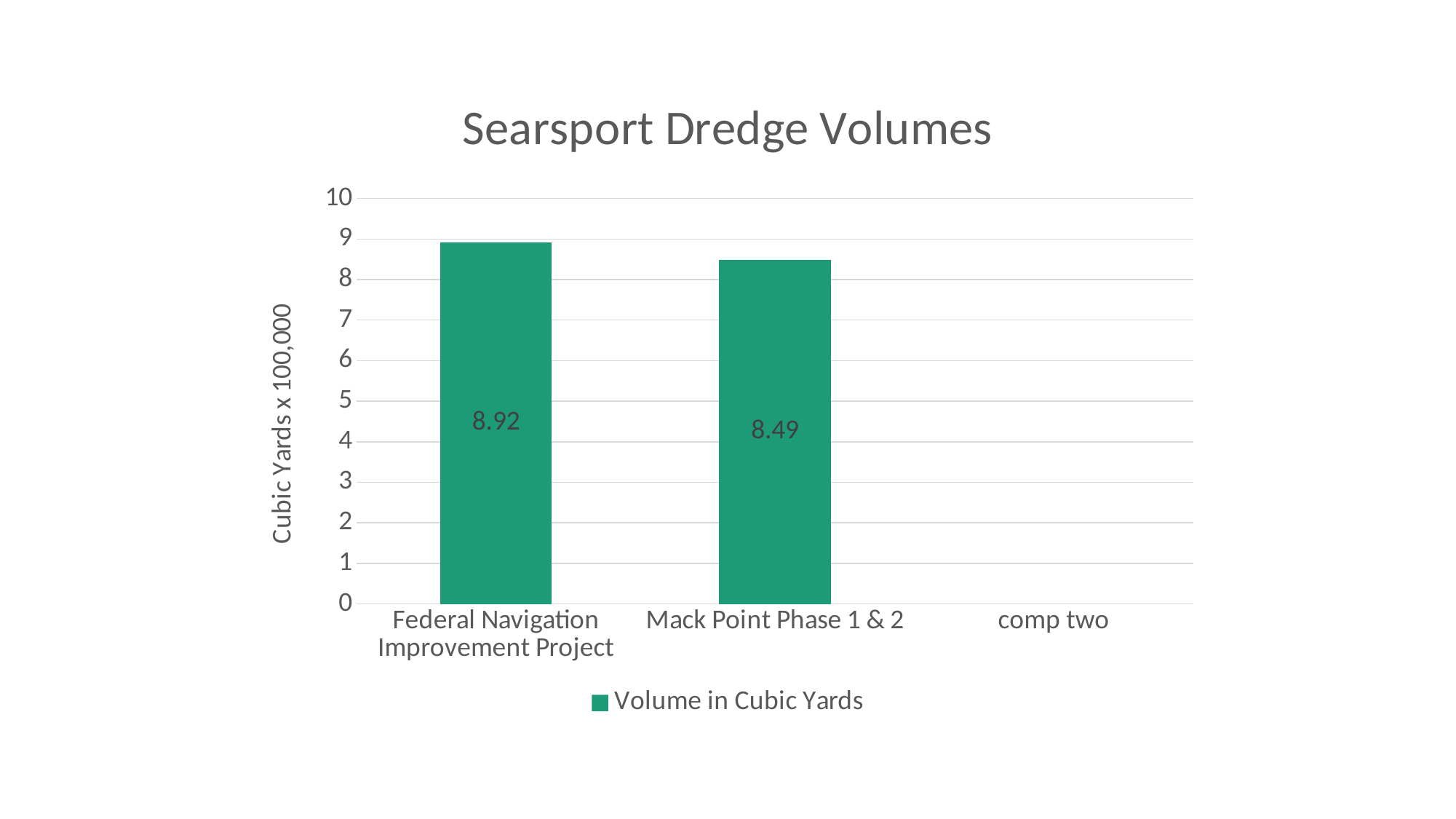
What kind of chart is shown? bar chart What is the value for Mack Point Phase 1 & 2? 8.49 What is the label of the y axis? Cubic Yards x 100,000 Is the value for Mack Point Phase 1 & 2 greater or less than 9? less What is the value for Federal Navigation Improvement Project? 8.92 Which category has the highest value? Federal Navigation Improvement Project Which is larger, the value for Federal Navigation Improvement Project or the value for Mack Point Phase 1 & 2? Federal Navigation Improvement Project What is the title of the chart? Searsport Dredge Volumes How many categories are shown on the x axis? 3 Is the value for Federal Navigation Improvement Project greater or less than 8? greater What is the difference between the values for Federal Navigation Improvement Project and Mack Point Phase 1 & 2? 0.43 How many series does the legend list? 1